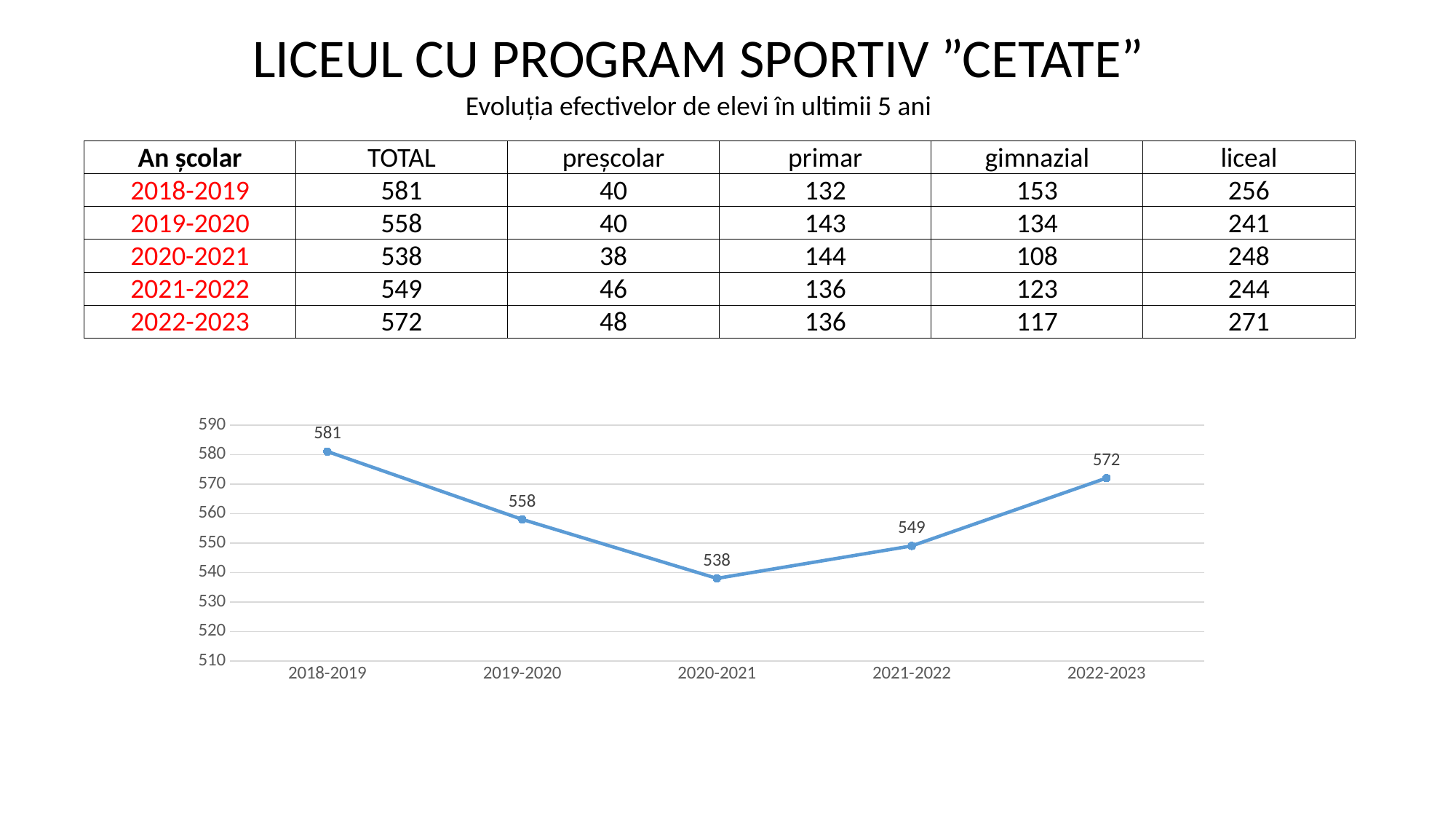
Which school year has the lowest plotted value? 2020-2021 What is the value plotted for 2022-2023? 572 What kind of chart is shown on the slide? line chart What is the difference between the values for 2022-2023 and 2021-2022? 23 What is the value plotted for 2018-2019? 581 What is the value plotted for 2020-2021? 538 Is the value for 2021-2022 greater or less than 540? greater How many school years are plotted on the chart? 5 What is the difference between the values for 2018-2019 and 2020-2021? 43 Which school year has the highest plotted value? 2018-2019 Which is larger, the value for 2019-2020 or the value for 2021-2022? 2019-2020 Does the plotted value rise or fall from 2020-2021 to 2022-2023? rise